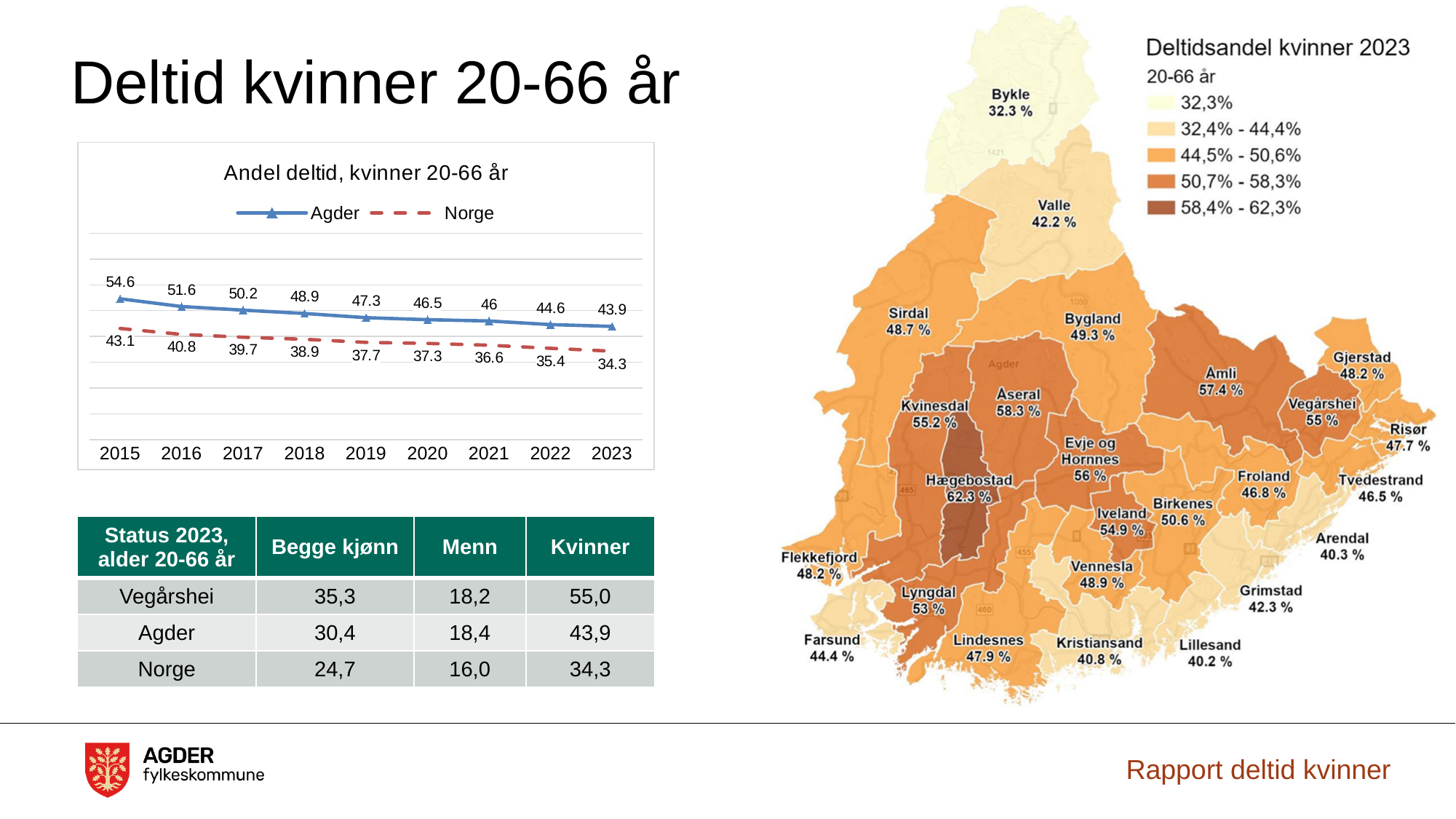
In the chart 'Andel deltid, kvinner 20-66 år', what is the difference between the Agder and Norge values in 2015? 11.5 How many series does the legend of the chart 'Andel deltid, kvinner 20-66 år' list? 2 In the chart 'Andel deltid, kvinner 20-66 år', do the Agder values rise or fall from 2015 to 2023? Fall What kind of chart is 'Andel deltid, kvinner 20-66 år'? Line chart In the chart 'Andel deltid, kvinner 20-66 år', what is the difference between the Agder and Norge values in 2023? 9.6 In the chart 'Andel deltid, kvinner 20-66 år', in which year is the Agder value highest? 2015 In the chart 'Andel deltid, kvinner 20-66 år', which series has the higher value in 2020, Agder or Norge? Agder In the chart 'Andel deltid, kvinner 20-66 år', what is the value for Agder in 2019? 47.3 In the chart 'Andel deltid, kvinner 20-66 år', what is the value for Agder in 2015? 54.6 How many years are shown on the x axis of the chart 'Andel deltid, kvinner 20-66 år'? 9 In the chart 'Andel deltid, kvinner 20-66 år', in which year is the Norge value lowest? 2023 In the chart 'Andel deltid, kvinner 20-66 år', what is the value for Norge in 2023? 34.3